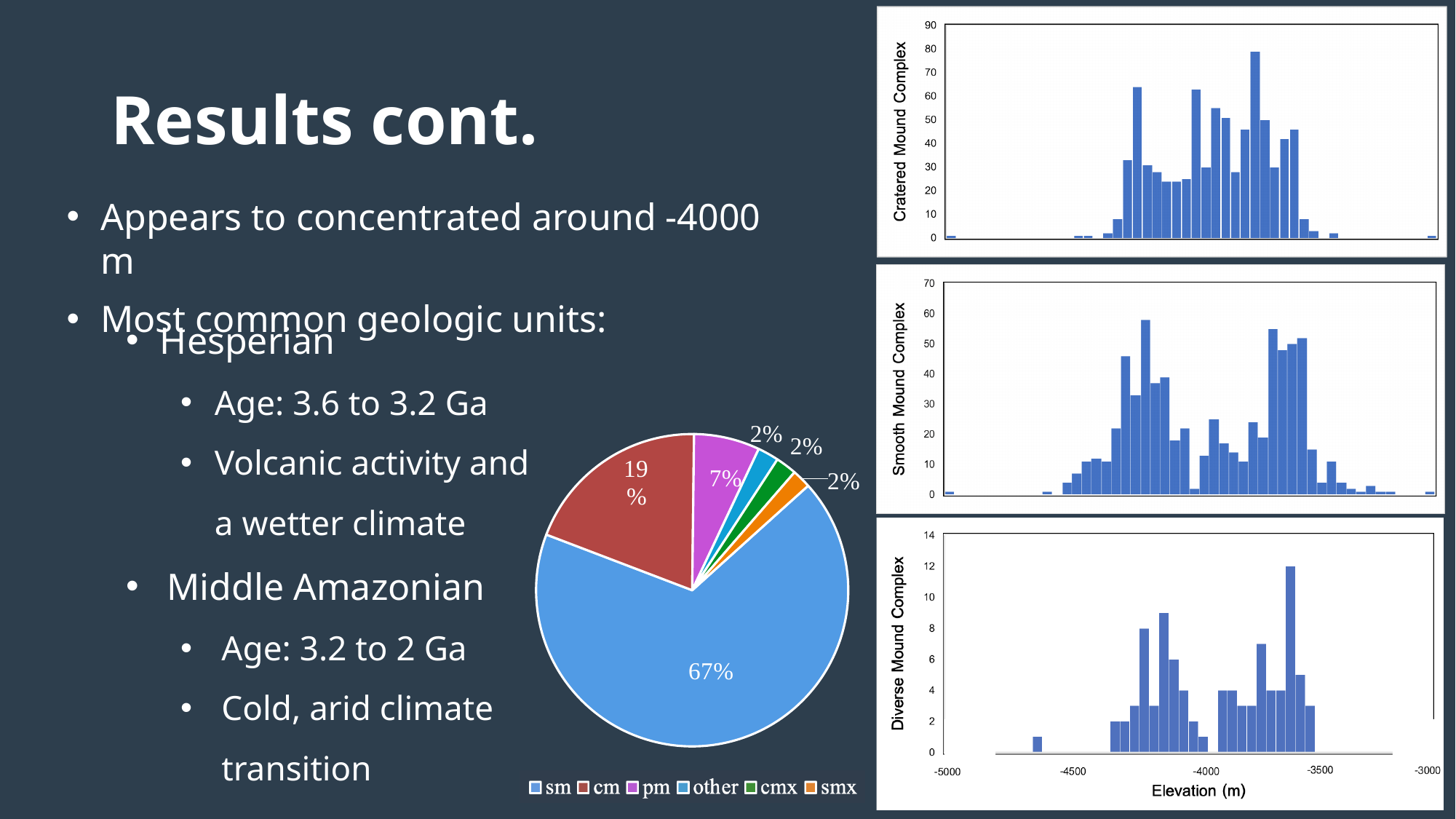
In the pie chart, what share does the pm slice have? 7% In the pie chart, which is larger, the cm slice or the pm slice? cm In the pie chart, what share does the cm slice have? 19% What kind of chart is the Cratered Mound Complex chart on the right? Bar chart What is the x-axis label of the Diverse Mound Complex chart? Elevation (m) In the pie chart, what is the difference between the sm share and the cm share? 48% In the Smooth Mound Complex chart, is the tallest bar greater or less than 50? greater In the Cratered Mound Complex chart, is the tallest bar greater or less than 70? greater In the pie chart, which category has the largest slice? sm In the pie chart, how many categories does the legend list? 6 In the pie chart, what colour is the sm slice? Blue In the pie chart, what share does the sm slice have? 67%